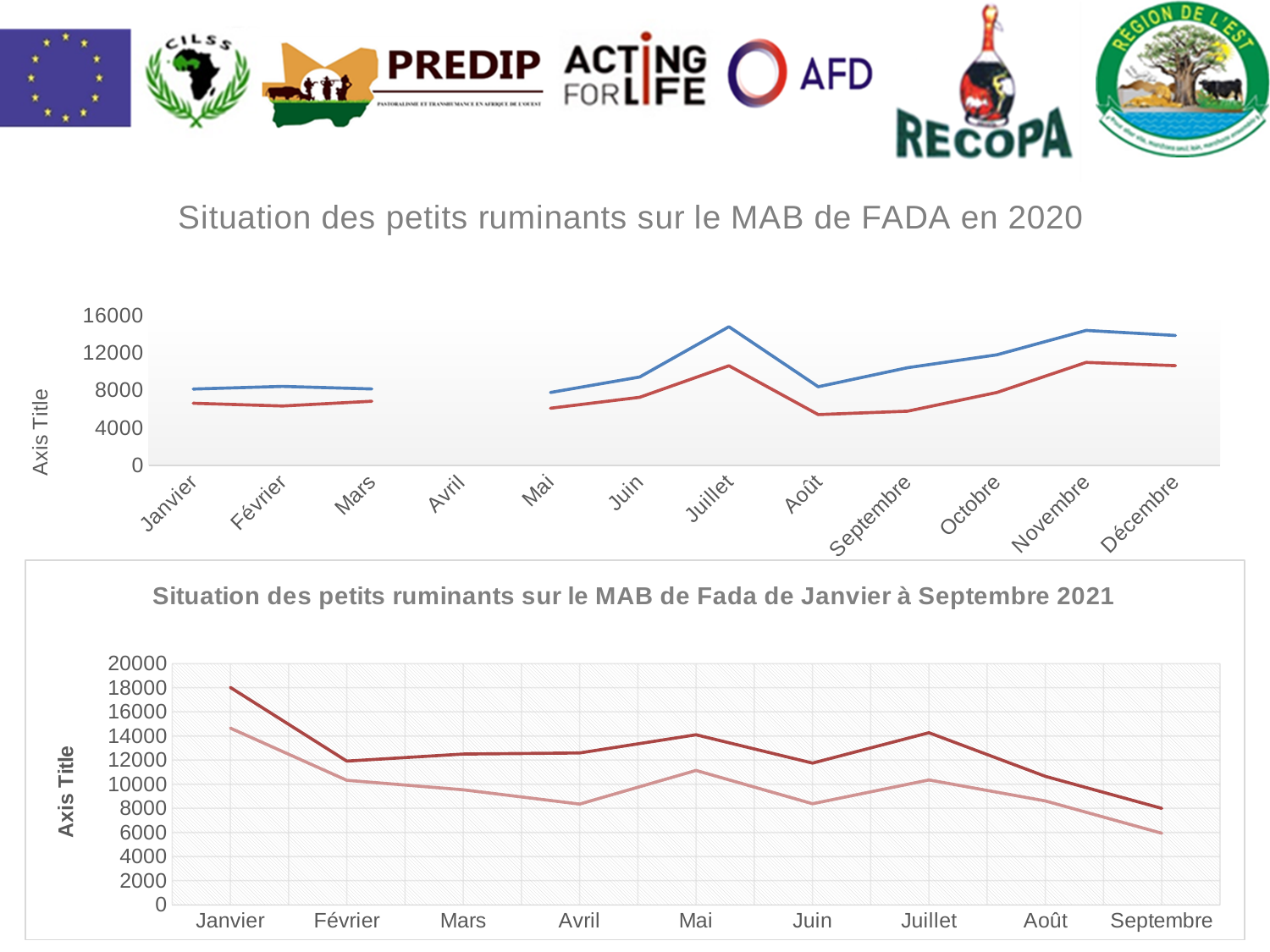
In the bottom chart (2021), in which month does the dark red line reach its lowest value? Septembre In the top chart (2020), is the value of the red line for Août greater or less than 8000? less In the bottom chart (2021), in which month does the dark red line reach its highest value? Janvier In the bottom chart (2021), does the dark red line rise or fall from Juillet to Septembre? fall In the bottom chart (2021), is the value of the lighter red line for Avril greater or less than 10000? less In the top chart (2020), is the value of the blue line for Juillet greater or less than 12000? greater How many months are shown on the x axis of the top chart (2020)? 12 In the top chart (2020), which month has no data plotted for either line? Avril What type of chart is the top chart titled 'Situation des petits ruminants sur le MAB de FADA en 2020'? line chart In the top chart (2020), in which month does the blue line reach its highest value? Juillet How many months are shown on the x axis of the bottom chart (Janvier à Septembre 2021)? 9